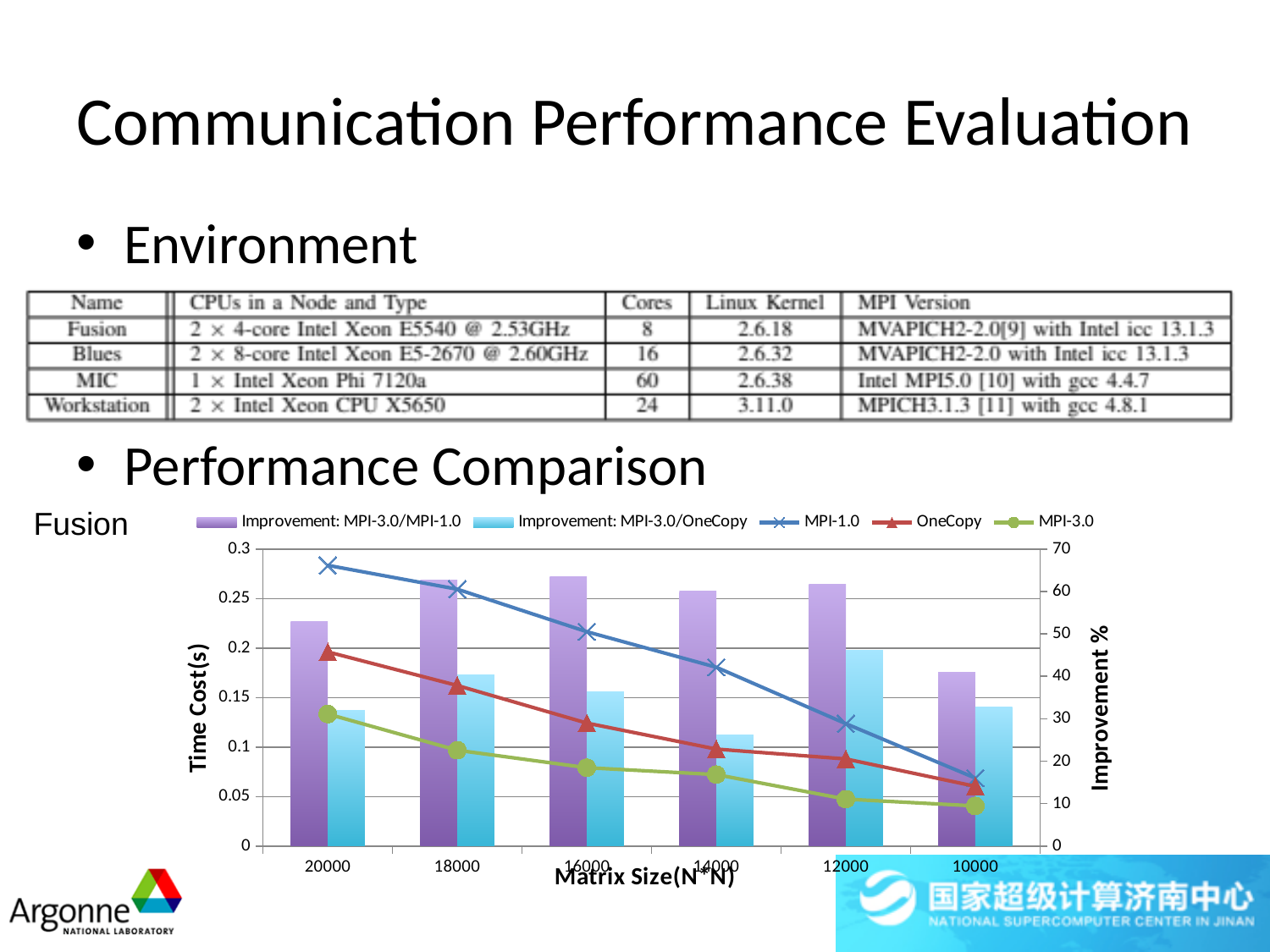
Is the Improvement: MPI-3.0/MPI-1.0 value at matrix size 16000 greater or less than 60? greater At which matrix size is the MPI-1.0 time cost lowest? 10000 How many matrix sizes are shown on the x axis of the chart? 6 Is the MPI-3.0 time cost at matrix size 20000 greater or less than 0.15? less What kind of chart is shown on the slide? Combined bar and line chart Does the MPI-1.0 time cost rise or fall as you move along the x axis from 20000 to 10000? Fall At matrix size 20000, which has the larger time cost, OneCopy or MPI-3.0? OneCopy At which matrix size is the Improvement: MPI-3.0/OneCopy bar tallest? 12000 What is the title of the right-hand vertical axis of the chart? Improvement % Is the MPI-1.0 time cost at matrix size 20000 greater or less than 0.25? greater At which matrix size is the MPI-1.0 time cost highest? 20000 How many series does the chart legend list? 5